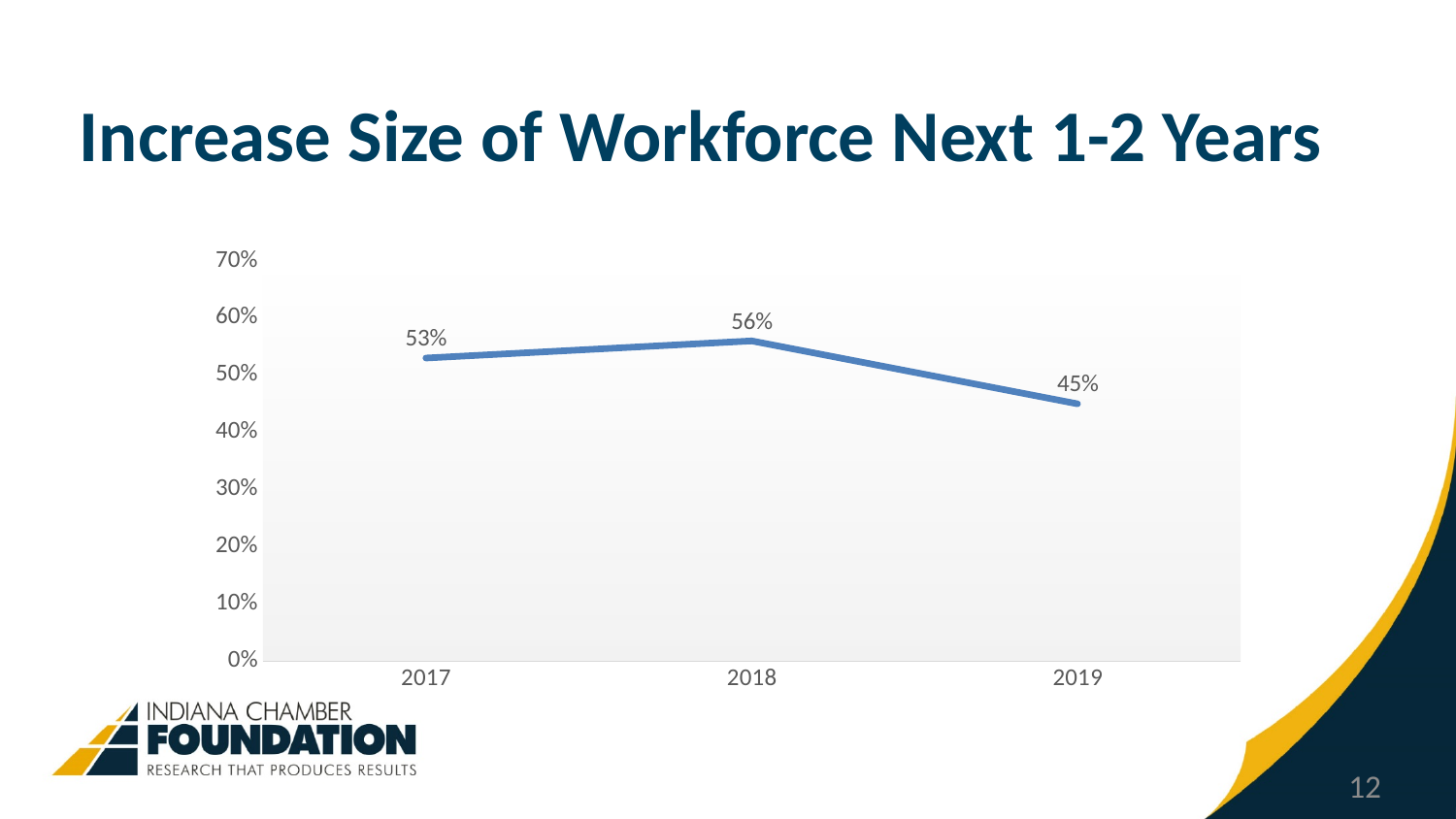
Is the value for 2019 greater or less than 50%? less How many years are plotted on the chart? 3 What is the difference between the values for 2018 and 2019? 11% Which is larger, the value for 2017 or the value for 2019? 2017 What is the difference between the values for 2017 and 2018? 3% What is the value for 2017? 53% What kind of chart is shown on the slide? line chart Which year has the highest value? 2018 What is the value for 2018? 56% What is the value for 2019? 45% Which year has the lowest value? 2019 What is the title of the chart? Increase Size of Workforce Next 1-2 Years